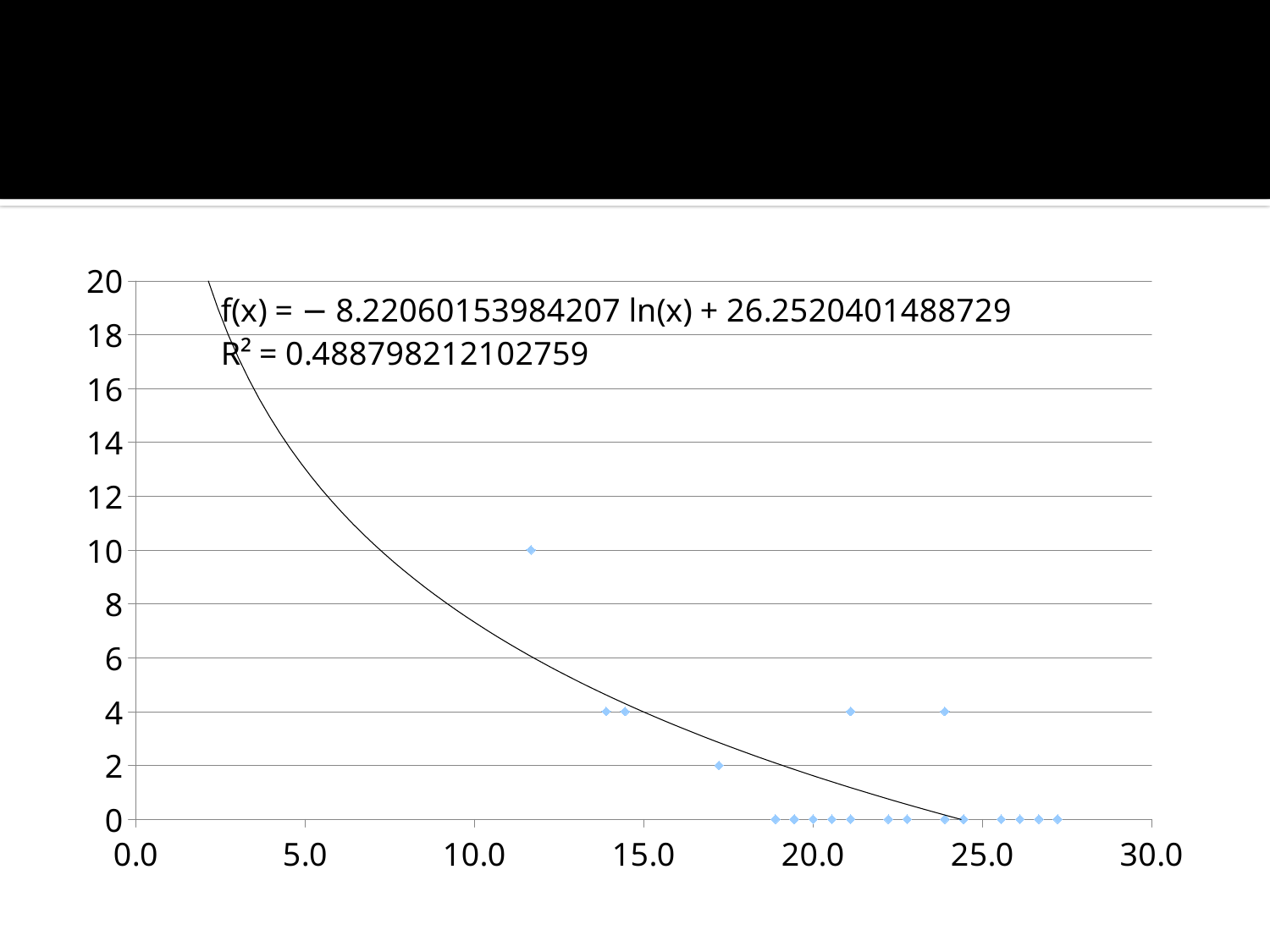
What is the maximum value shown on the y axis? 20 What is the lowest y value reached by the data points on the chart? 0 What is the maximum value shown on the x axis? 30.0 How many data points have a y value of 10? 1 Is the y value of the data point near x = 17 greater or less than 4? less What kind of chart is shown on the slide? scatter chart Is the R² value shown on the chart greater or less than 0.5? less What is the R² value printed on the chart? 0.488798212102759 What is the constant term in the fitted equation f(x) shown on the chart? 26.2520401488729 What is the highest y value reached by any data point on the chart? 10 According to the fitted trendline, do the values rise or fall as x increases? fall